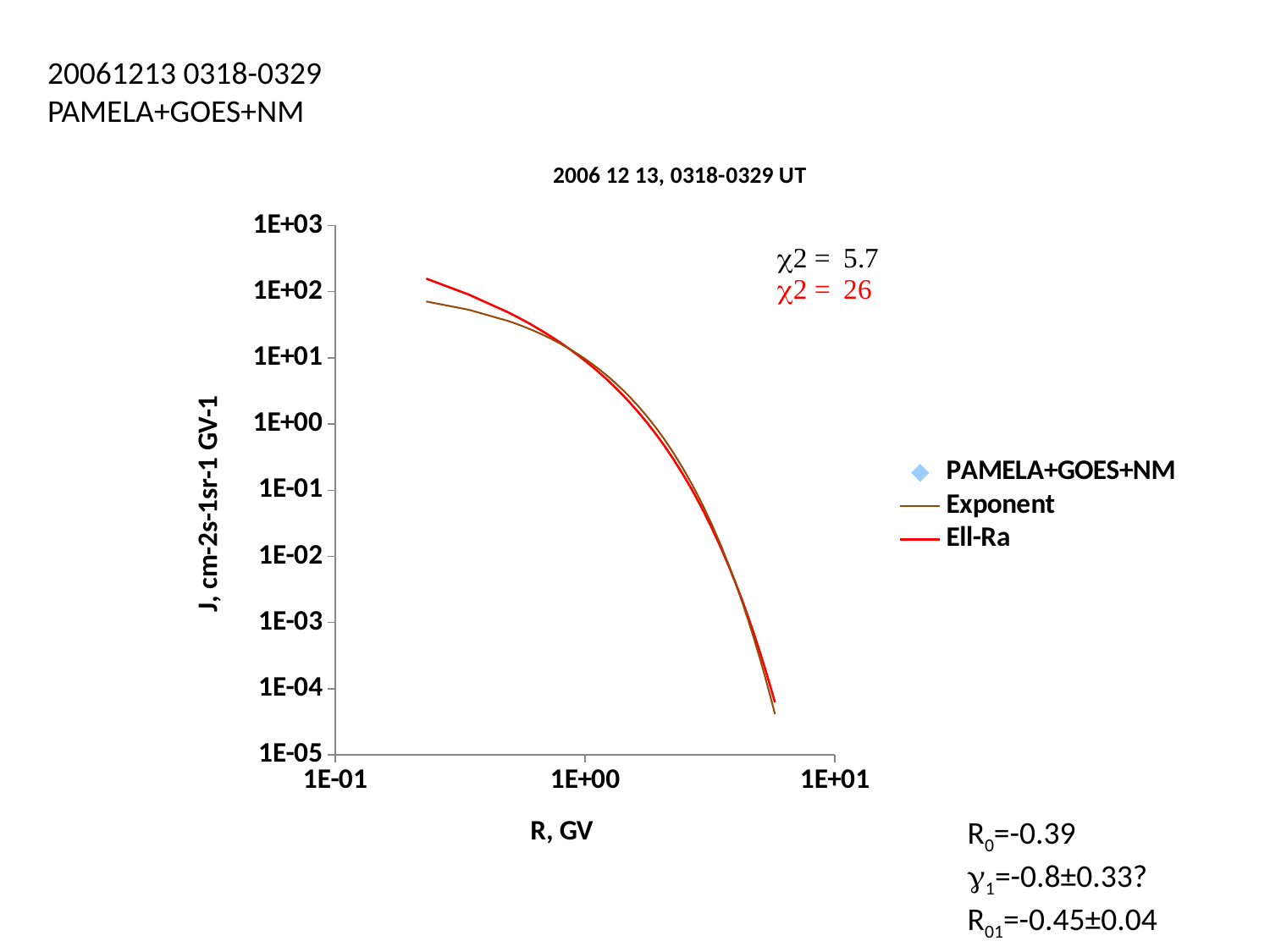
Do the plotted curves rise or fall as R increases along the x axis? fall What is the title of the chart? 2006 12 13, 0318-0329 UT What chi-squared value is printed in black on the chart? 5.7 At the right end of the curves (largest R), is the Ell-Ra value greater or less than 1E-03? less At the left end of the curves (smallest R), which series has the higher value, Exponent or Ell-Ra? Ell-Ra How many series does the chart legend list? 3 At the left end of the curves (smallest R), is the Exponent value greater or less than 1E+02? less What is the label of the x axis? R, GV What chi-squared value is printed in red on the chart? 26 At the right end of the curves (largest R), is the Exponent value greater or less than 1E-04? less What kind of chart is shown on the slide? line chart